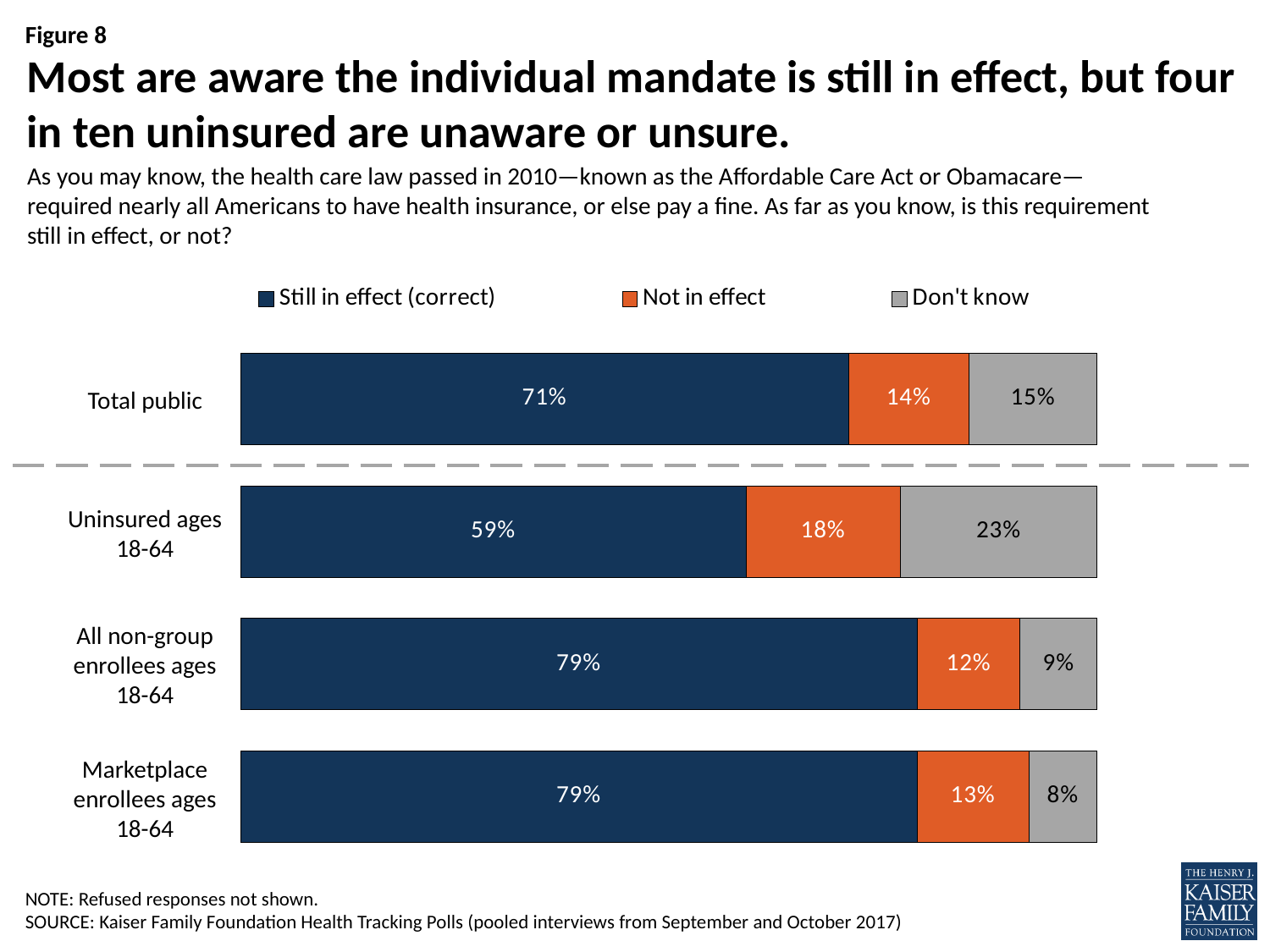
What is the total of the three segments for the total public bar? 100% What percentage of the total public said the requirement is still in effect? 71% Is the "Not in effect" share larger for uninsured ages 18-64 or for all non-group enrollees ages 18-64? Uninsured ages 18-64 What percentage of uninsured ages 18-64 answered "Don't know"? 23% Which legend entry is marked as the correct answer? Still in effect (correct) What is the difference between the "Still in effect" share for all non-group enrollees ages 18-64 and for the total public? 8 percentage points What kind of chart is shown on the slide? Stacked bar chart What percentage of marketplace enrollees ages 18-64 said the requirement is not in effect? 13% How many groups are shown in the chart? 4 How many series does the legend list? 3 Which group has the lowest share saying the requirement is still in effect? Uninsured ages 18-64 Which group has the highest "Don't know" share? Uninsured ages 18-64